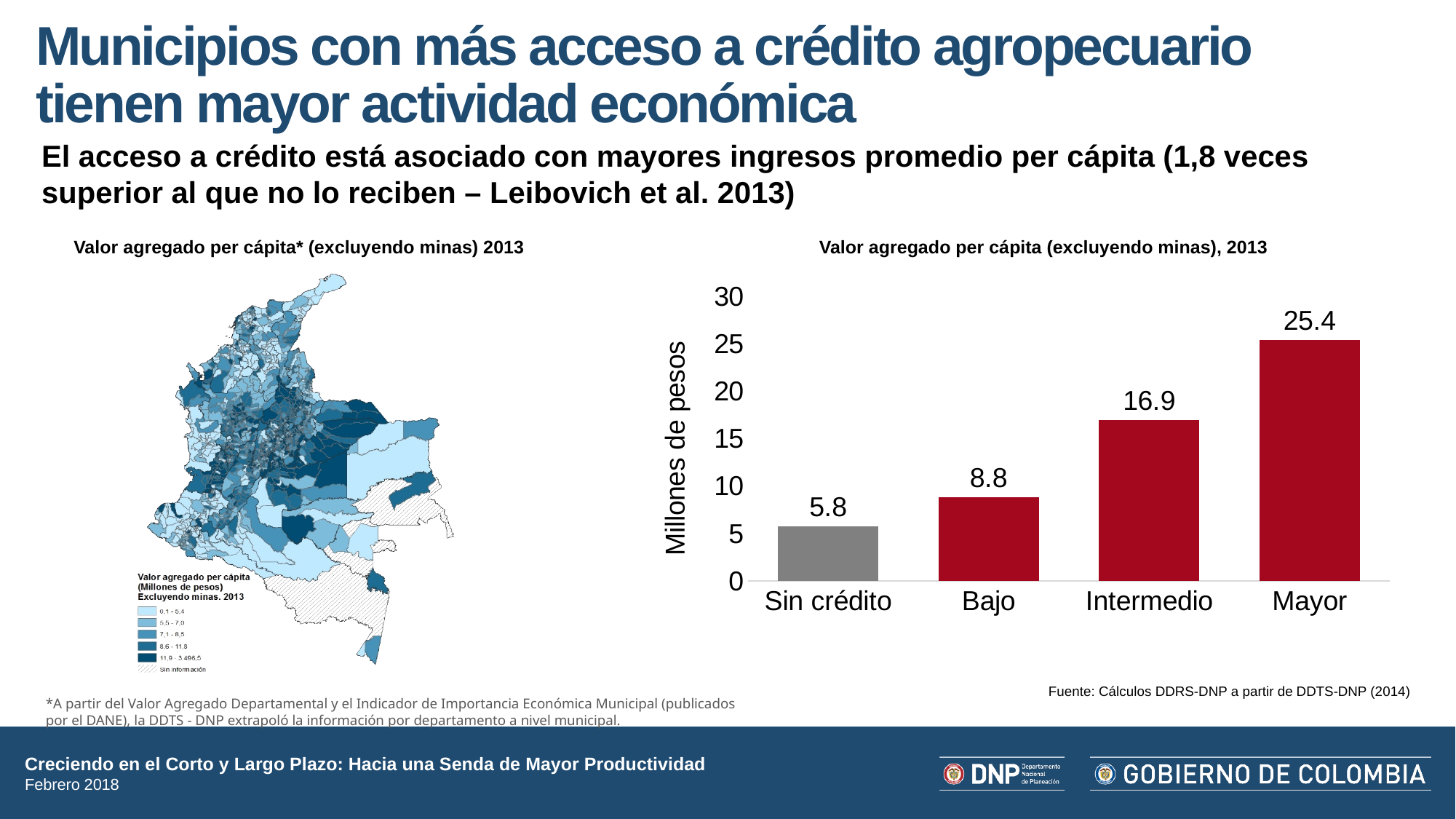
In the bar chart on the right, what is the difference between the values for Mayor and Sin crédito? 19.6 In the bar chart on the right, do the values rise or fall from Sin crédito to Mayor? Rise In the bar chart on the right, which category has the lowest value? Sin crédito In the bar chart on the right, what is the value for Intermedio? 16.9 In the bar chart on the right, which category has the highest value? Mayor In the bar chart on the right, which is larger, the value for Bajo or the value for Intermedio? Intermedio In the bar chart on the right, what is the value for Mayor? 25.4 In the bar chart on the right, what is the label of the vertical axis? Millones de pesos In the bar chart on the right, what is the value for Bajo? 8.8 What kind of chart is shown on the right side of the slide? Bar chart In the bar chart 'Valor agregado per cápita (excluyendo minas), 2013', what is the value for Sin crédito? 5.8 In the bar chart on the right, how many categories are shown? 4